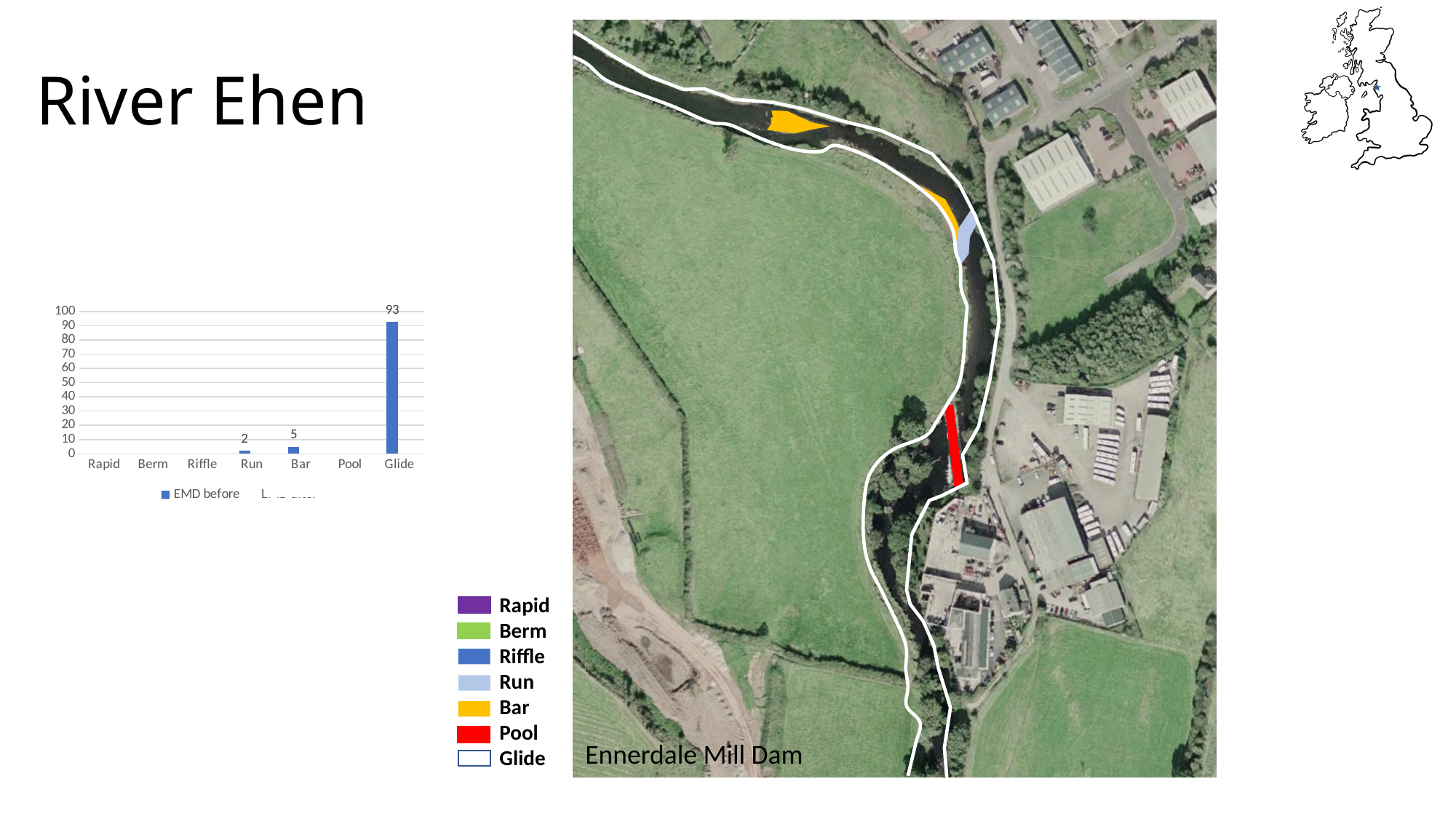
What is the difference between the values for Glide and Bar in the bar chart? 88 Which has the larger value in the bar chart, Bar or Run? Bar How many categories are shown on the x axis of the bar chart? 7 What is the first legend entry shown below the bar chart? EMD before What is the value for Glide in the bar chart? 93 Is the value for Glide in the bar chart greater or less than 50? greater What is the maximum value shown on the y axis of the bar chart? 100 What kind of chart is shown on the slide? bar chart What is the value for Bar in the bar chart? 5 What is the value for Run in the bar chart? 2 What is the difference between the values for Bar and Run in the bar chart? 3 Which category has the highest value in the bar chart? Glide